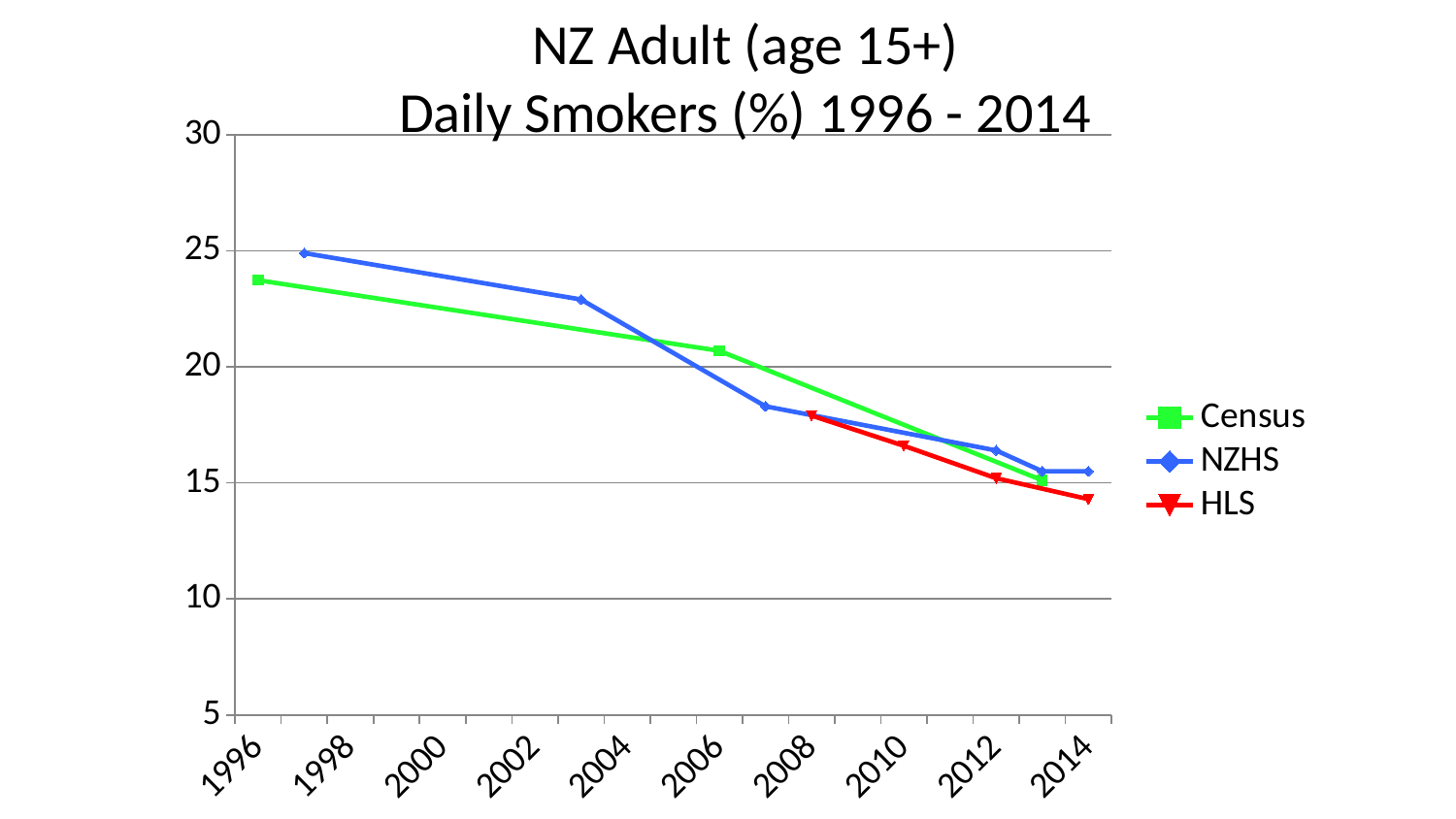
Is the Census value for 1996 greater or less than 20? greater How many series does the legend list? 3 What kind of chart is shown on the slide? line chart What is the title of the chart? NZ Adult (age 15+) Daily Smokers (%) 1996 - 2014 Which series is drawn in red? HLS How many data points are plotted for the Census series? 3 Is the HLS value for 2010 greater or less than 20? less Around 2014, which is larger: the NZHS value or the HLS value? NZHS Do the values for the NZHS series rise or fall from 1996 to 2014? fall Do the values for the Census series rise or fall over time? fall Which series has the lowest value at the end of the period, in 2014? HLS Is the HLS value for 2014 greater or less than 15? less